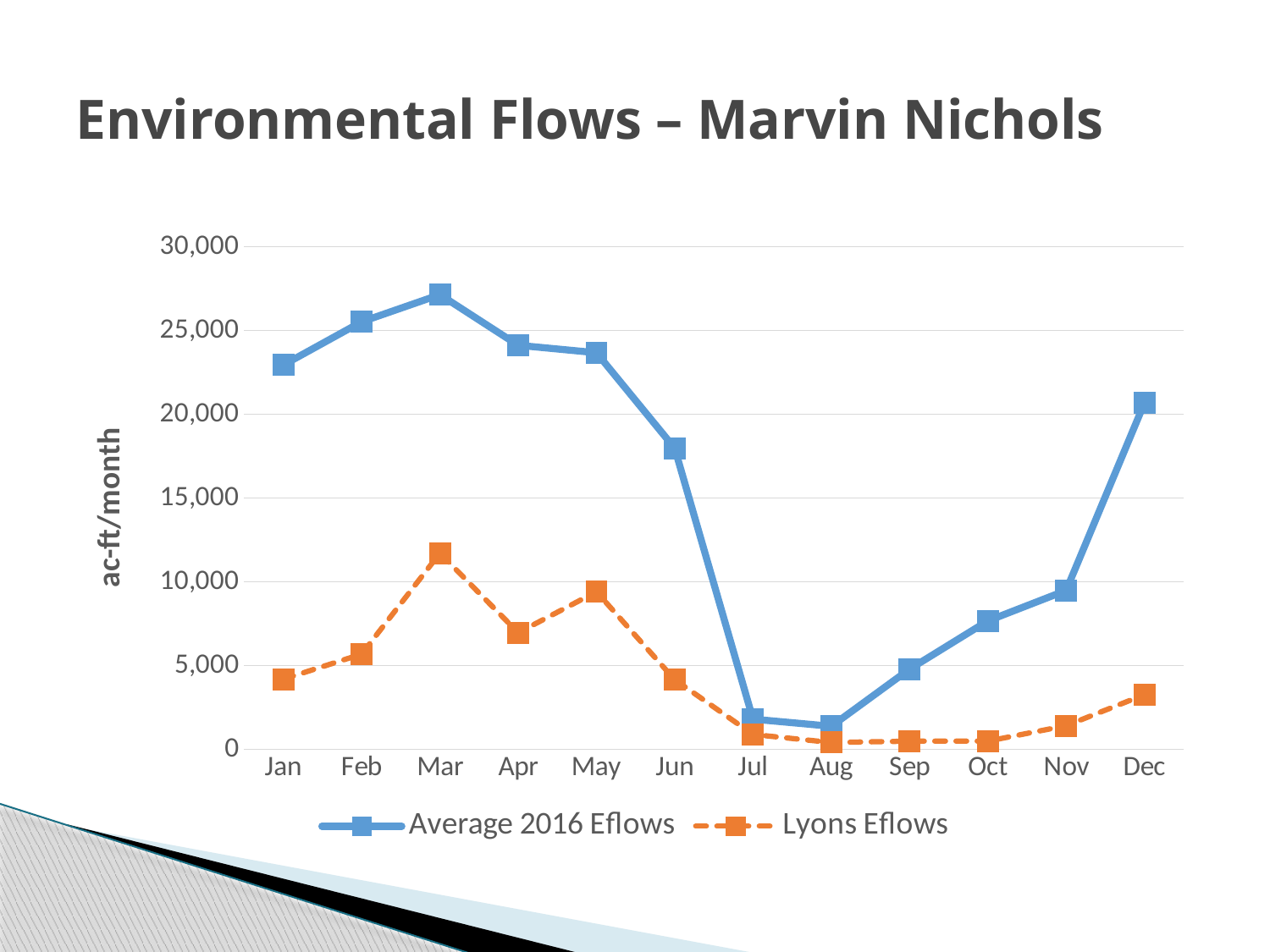
What kind of chart is shown on the slide? line chart Is the Lyons Eflows value for Mar greater or less than 10,000? greater How many series does the legend list? 2 Which is larger in Jan: the Average 2016 Eflows value or the Lyons Eflows value? Average 2016 Eflows In which month does the Average 2016 Eflows series reach its highest value? Mar How many months are plotted along the x axis? 12 Is the Average 2016 Eflows value for Jul greater or less than 5,000? less Does the Average 2016 Eflows series rise or fall from Aug to Dec? rise Is the Average 2016 Eflows value for Mar greater or less than 25,000? greater In which month does the Lyons Eflows series reach its highest value? Mar What is the label on the y axis? ac-ft/month